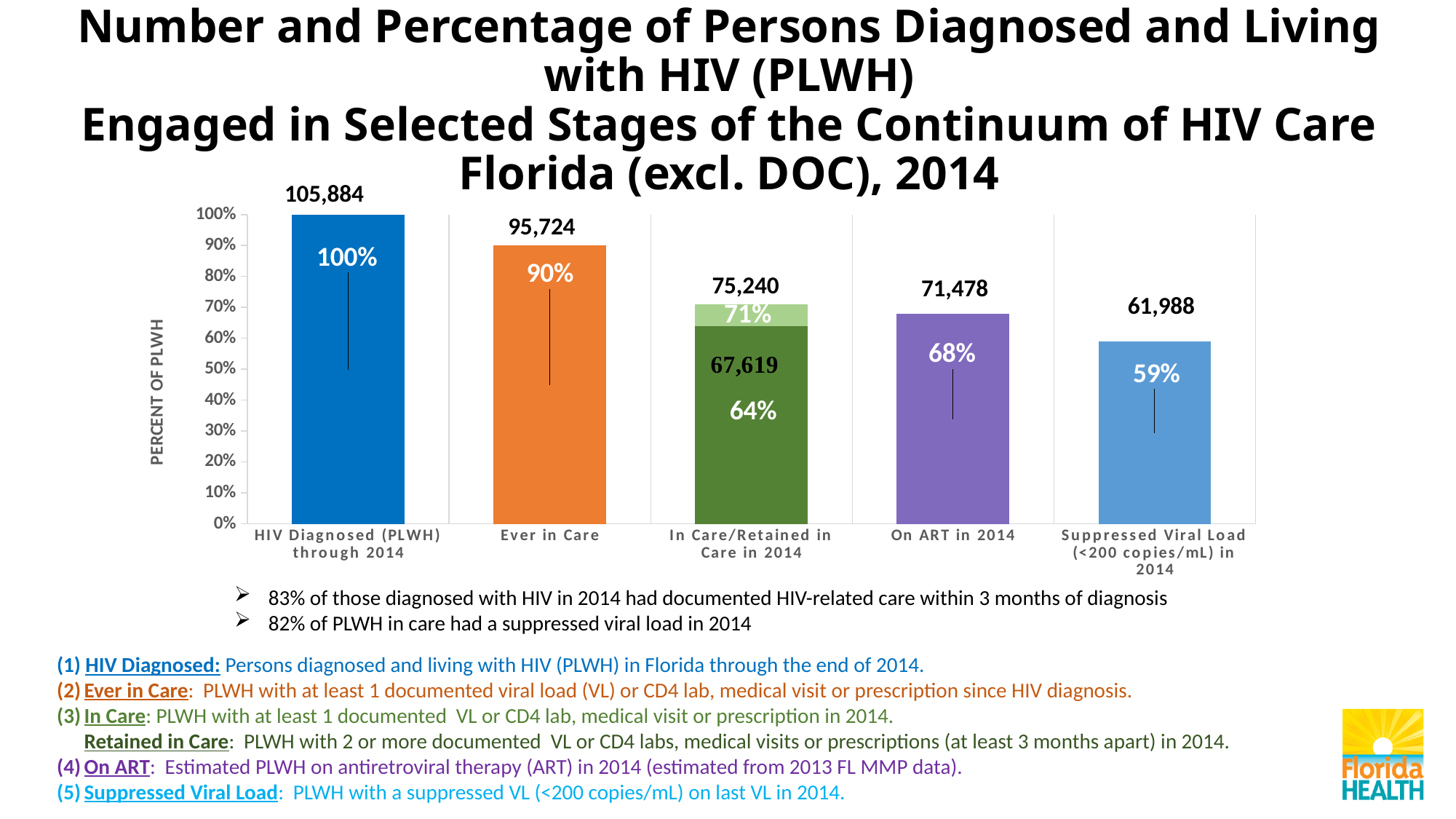
What kind of chart is shown on the slide? bar chart Which category has the lowest percentage of PLWH? Suppressed Viral Load (<200 copies/mL) in 2014 What percentage is shown for 'On ART in 2014'? 68% What percentage is shown for the retained-in-care (dark green) portion of the 'In Care/Retained in Care in 2014' bar? 64% How many categories (stages of care) are shown on the x axis of the chart? 5 What is the number of persons shown for 'Suppressed Viral Load (<200 copies/mL) in 2014'? 61,988 What is the number of persons shown for 'HIV Diagnosed (PLWH) through 2014'? 105,884 What percentage of PLWH is shown for 'Ever in Care'? 90% What is the difference in the number of persons between 'Ever in Care' and 'On ART in 2014'? 24,246 Which category has the highest number of persons? HIV Diagnosed (PLWH) through 2014 What number is printed above the 'In Care/Retained in Care in 2014' bar? 75,240